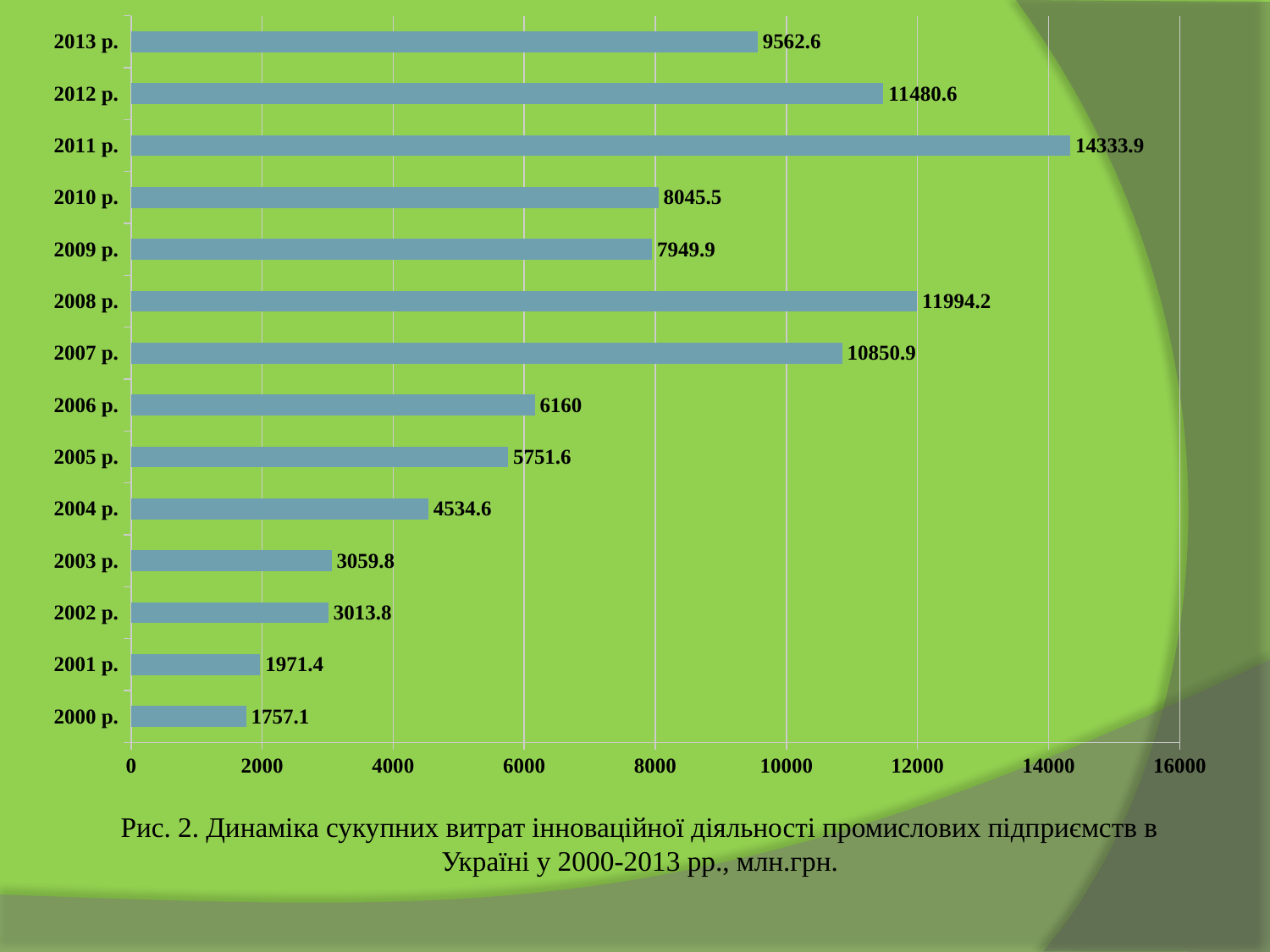
Is the value for 2010 р. greater or less than 8000? greater What is the maximum value shown on the horizontal axis? 16000 What is the difference between the values for 2003 р. and 2002 р.? 46 What is the difference between the values for 2012 р. and 2013 р.? 1918 What kind of chart is shown on the slide? bar chart Which year has the highest value? 2011 р. Which year has the lowest value? 2000 р. How many years are shown on the chart? 14 What is the value for 2011 р.? 14333.9 What is the value for 2006 р.? 6160 What is the value for 2000 р.? 1757.1 Which is larger, the value for 2008 р. or the value for 2007 р.? 2008 р.